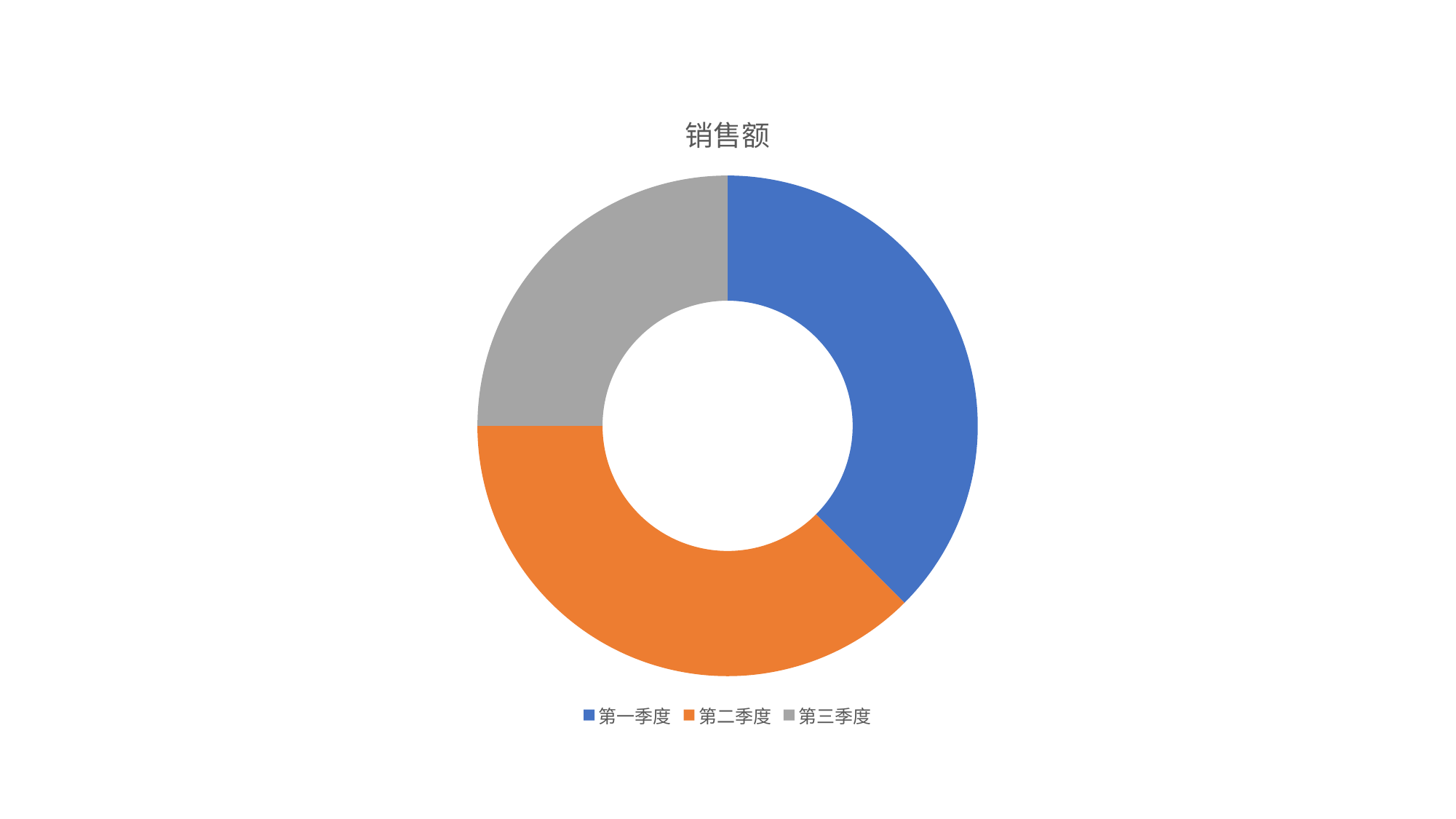
How many categories does the doughnut chart show? 3 Which category has the smallest share of the doughnut? 第三季度 Which is larger, the share for 第二季度 or the share for 第三季度? 第二季度 What kind of chart is shown on the slide? Doughnut chart What is the title of the chart? 销售额 Which colour represents 第二季度 in the chart? Orange Which is larger, the share for 第一季度 or the share for 第三季度? 第一季度 How many entries does the legend list? 3